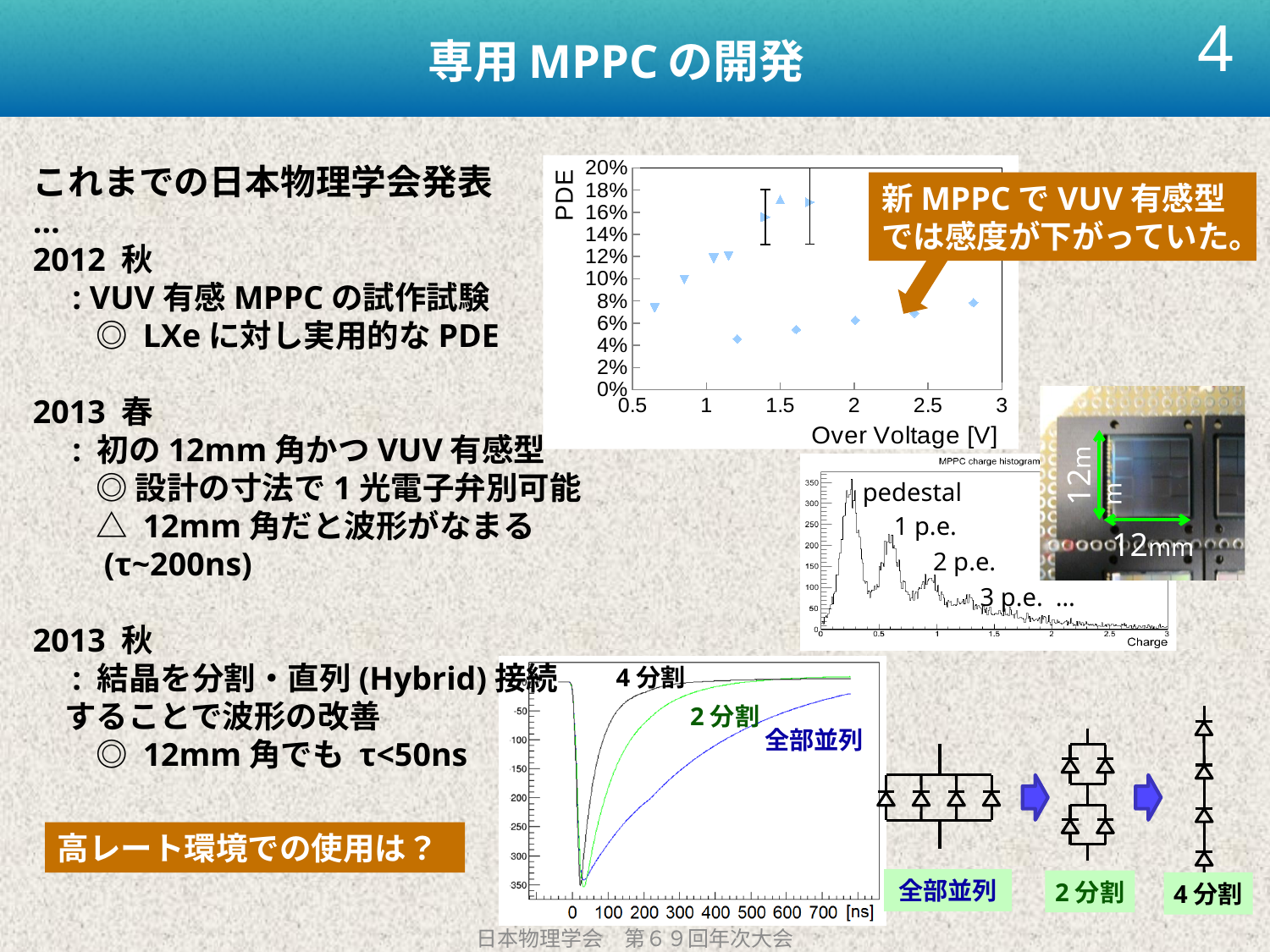
In the PDE versus Over Voltage chart, which marker series has the higher PDE values overall, the triangles or the diamonds? triangles In the PDE versus Over Voltage chart, what is the label of the x axis? Over Voltage [V] In the PDE versus Over Voltage chart, what is the label of the y axis? PDE In the waveform chart at the bottom, what is the maximum value shown on the x axis in ns? 700 In the waveform chart at the bottom, how many curves are plotted? 3 In the PDE versus Over Voltage chart, is the PDE of the diamond-marker series at an over voltage of about 1.2 V greater or less than 6%? less In the PDE versus Over Voltage chart, what kind of chart is it? scatter chart In the PDE versus Over Voltage chart, is the PDE of the triangle-marker series at an over voltage of about 1.5 V greater or less than 14%? greater In the PDE versus Over Voltage chart, how many diamond-marker points are plotted? 5 In the PDE versus Over Voltage chart, does the PDE of the diamond-marker series rise or fall as over voltage increases? rise